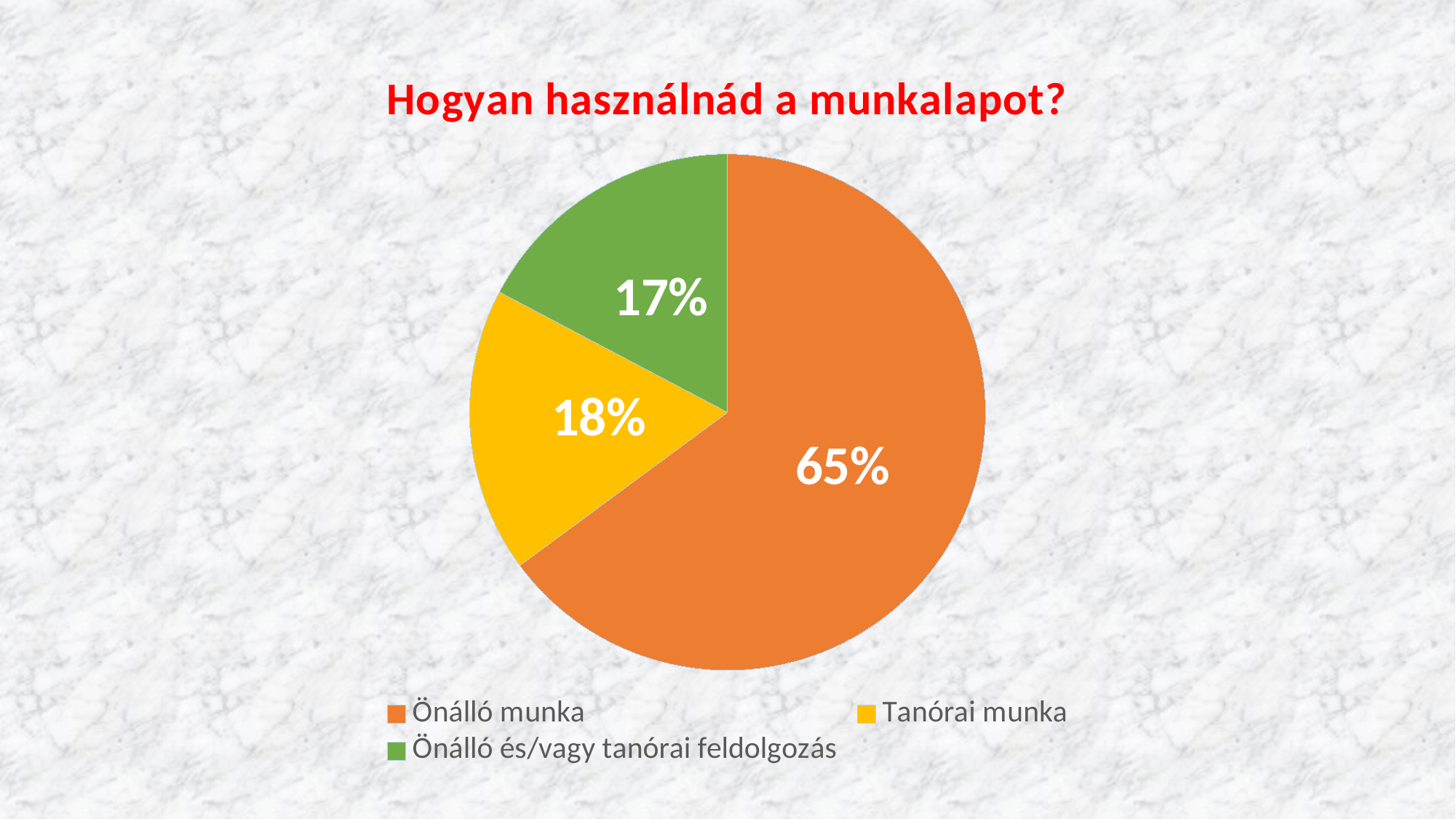
What share of the pie does "Tanórai munka" have? 18% What is the difference between the shares of "Önálló munka" and "Tanórai munka"? 47% Which category has the largest slice of the pie? Önálló munka What share of the pie does "Önálló és/vagy tanórai feldolgozás" have? 17% What is the title of the chart? Hogyan használnád a munkalapot? Which category has the smallest slice of the pie? Önálló és/vagy tanórai feldolgozás What colour is the slice for "Tanórai munka"? yellow How many slices does the pie chart have? 3 Which is larger, the share of "Önálló munka" or the share of "Önálló és/vagy tanórai feldolgozás"? Önálló munka What share of the pie does "Önálló munka" have? 65% What kind of chart is shown on the slide? pie chart What is the difference between the shares of "Tanórai munka" and "Önálló és/vagy tanórai feldolgozás"? 1%